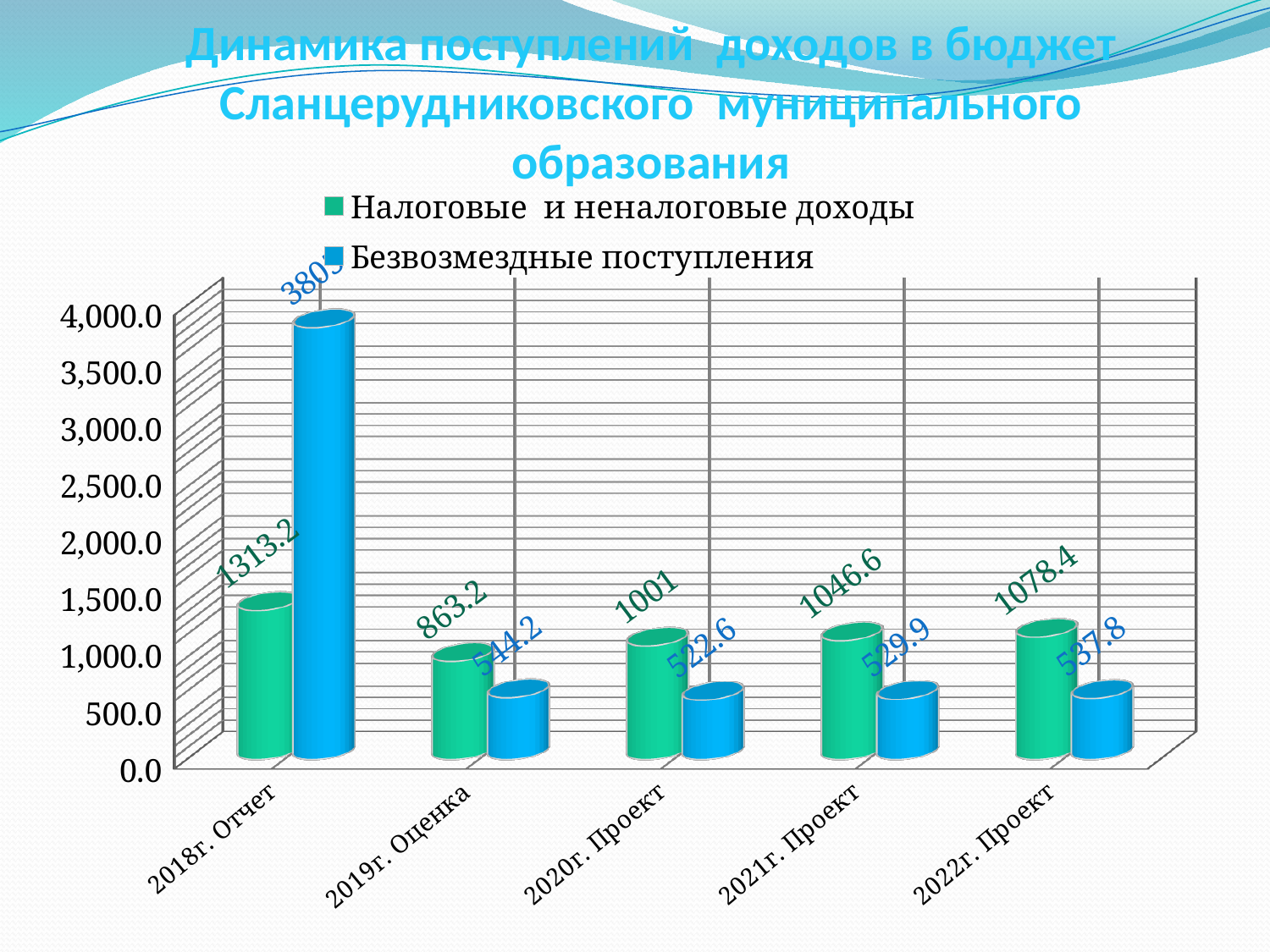
What is the difference between Налоговые и неналоговые доходы for 2022г. Проект and 2021г. Проект? 31.8 Do the values of Налоговые и неналоговые доходы rise or fall from 2019г. Оценка to 2022г. Проект? rise In which category is Налоговые и неналоговые доходы the highest? 2018г. Отчет What is the value of Налоговые и неналоговые доходы for 2020г. Проект? 1001 What is the value of Налоговые и неналоговые доходы for 2018г. Отчет? 1313.2 How many categories are shown on the x axis? 5 What is the value of Безвозмездные поступления for 2019г. Оценка? 544.2 For 2020г. Проект, which series has the larger value: Налоговые и неналоговые доходы or Безвозмездные поступления? Налоговые и неналоговые доходы How many series does the legend list? 2 Is the value of Безвозмездные поступления for 2018г. Отчет greater or less than 3,500.0? greater In which category is Налоговые и неналоговые доходы the lowest? 2019г. Оценка What is the value of Безвозмездные поступления for 2022г. Проект? 537.8